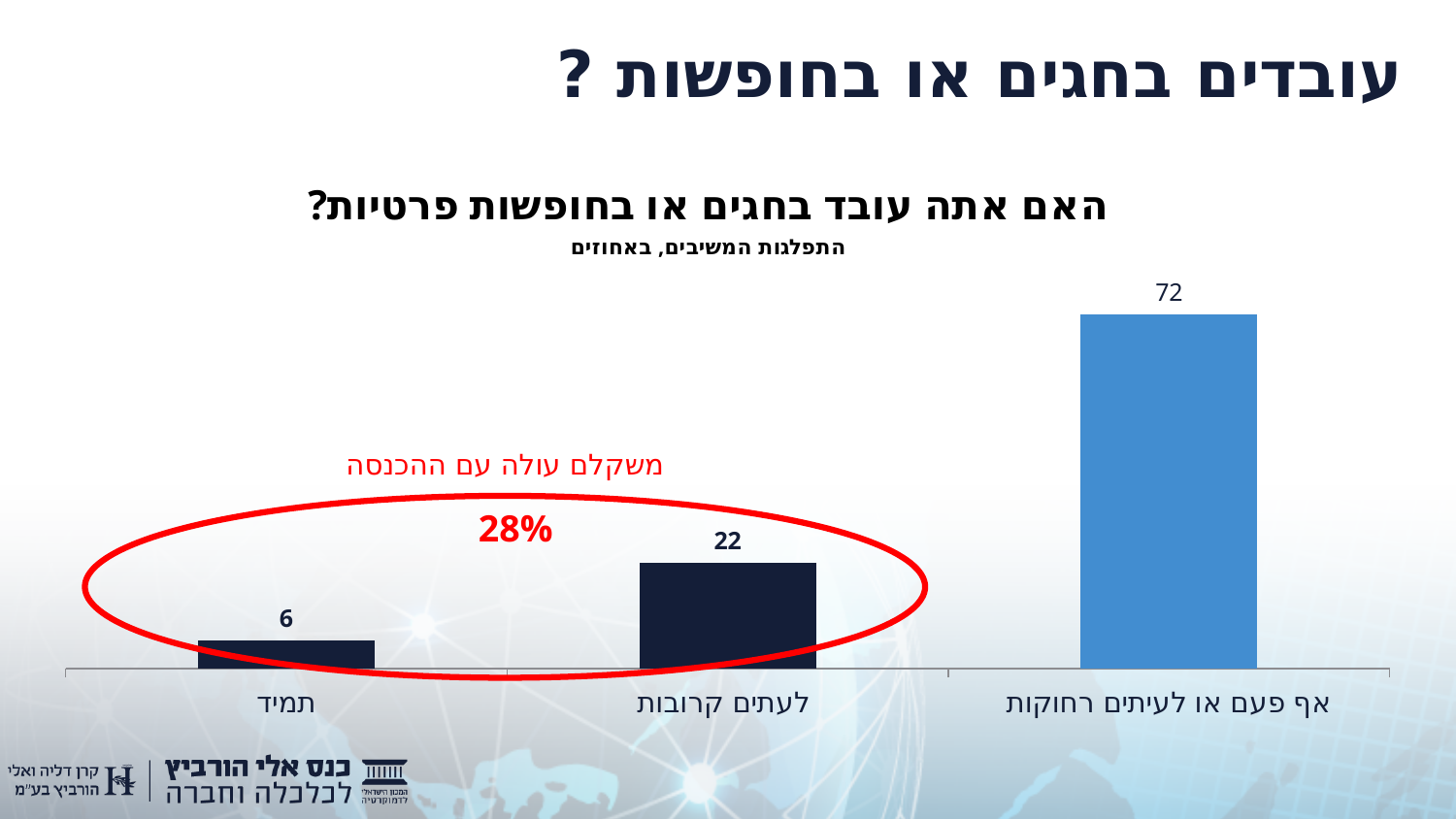
What is the title of the chart? האם אתה עובד בחגים או בחופשות פרטיות? Which is larger, the value for "לעתים קרובות" or the value for "תמיד"? לעתים קרובות Which category has the lowest value? תמיד What is the value for the category "אף פעם או לעיתים רחוקות"? 72 What is the difference between the values for "אף פעם או לעיתים רחוקות" and "לעתים קרובות"? 50 What percentage is written inside the red circle on the chart? 28% What is the value for the category "תמיד"? 6 Which category has the highest value? אף פעם או לעיתים רחוקות What is the value for the category "לעתים קרובות"? 22 What is the combined value of "תמיד" and "לעתים קרובות"? 28 How many categories are shown on the chart? 3 What kind of chart is shown on the slide? bar chart